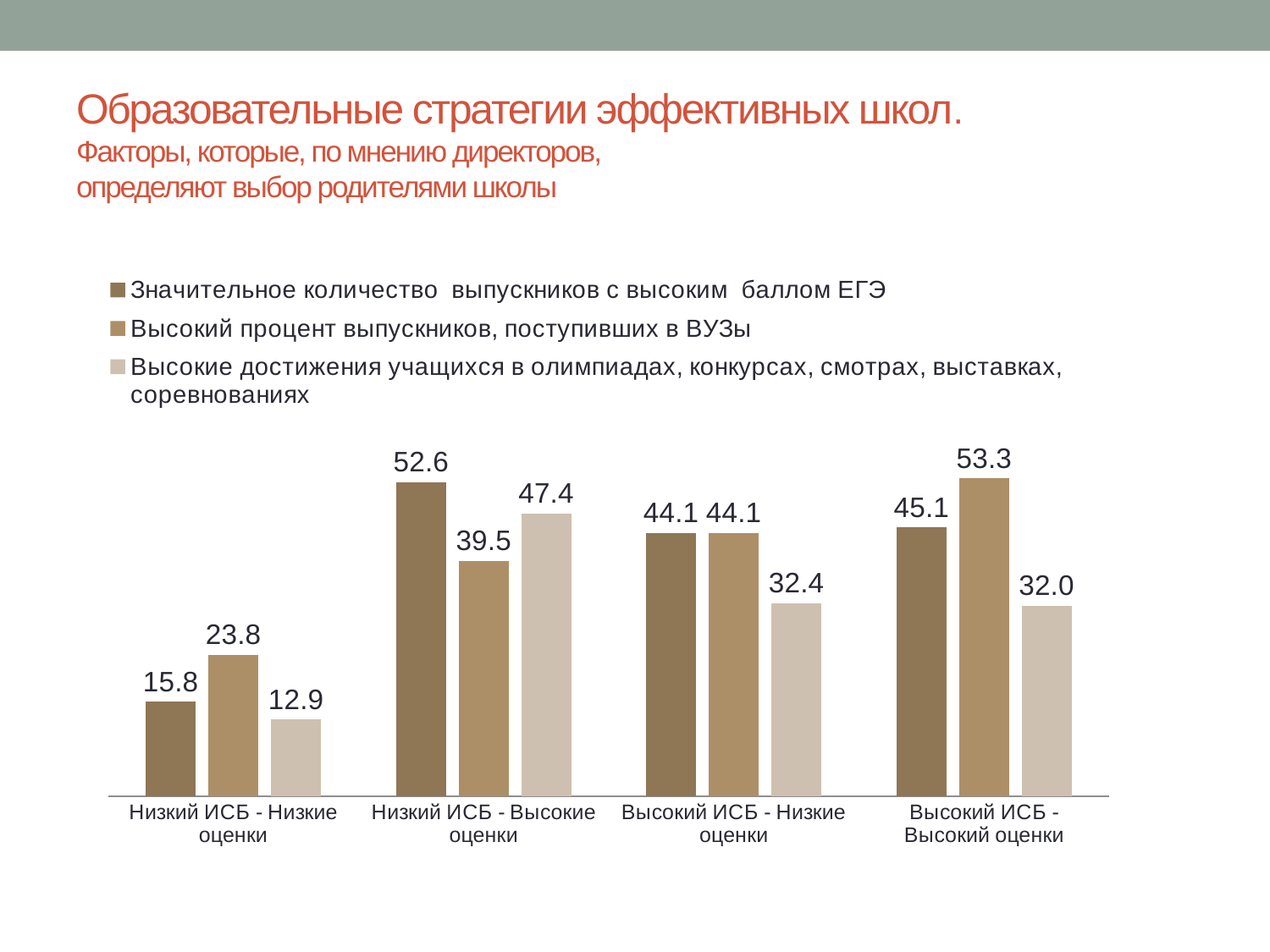
What is the value for 'Значительное количество выпускников с высоким баллом ЕГЭ' in the 'Низкий ИСБ - Низкие оценки' category? 15.8 What is the difference between the 'Высокий процент выпускников, поступивших в ВУЗы' value in 'Высокий ИСБ - Высокий оценки' and in 'Низкий ИСБ - Высокие оценки'? 13.8 Which category has the lowest value for 'Высокие достижения учащихся в олимпиадах, конкурсах, смотрах, выставках, соревнованиях'? Низкий ИСБ - Низкие оценки In the 'Высокий ИСБ - Высокий оценки' category, which is larger: the value for 'Высокий процент выпускников, поступивших в ВУЗы' or the value for 'Высокие достижения учащихся в олимпиадах, конкурсах, смотрах, выставках, соревнованиях'? Высокий процент выпускников, поступивших в ВУЗы Which category has the highest value for 'Значительное количество выпускников с высоким баллом ЕГЭ'? Низкий ИСБ - Высокие оценки What is the value for 'Высокие достижения учащихся в олимпиадах, конкурсах, смотрах, выставках, соревнованиях' in the 'Низкий ИСБ - Высокие оценки' category? 47.4 Which series is shown in the lightest colour in the legend? Высокие достижения учащихся в олимпиадах, конкурсах, смотрах, выставках, соревнованиях How many categories are shown on the x axis? 4 What kind of chart is shown on the slide? Bar chart How many series does the legend list? 3 What is the value for 'Высокий процент выпускников, поступивших в ВУЗы' in the 'Высокий ИСБ - Высокий оценки' category? 53.3 What is the difference between the 'Высокий процент выпускников, поступивших в ВУЗы' value and the 'Значительное количество выпускников с высоким баллом ЕГЭ' value in the 'Низкий ИСБ - Низкие оценки' category? 8.0